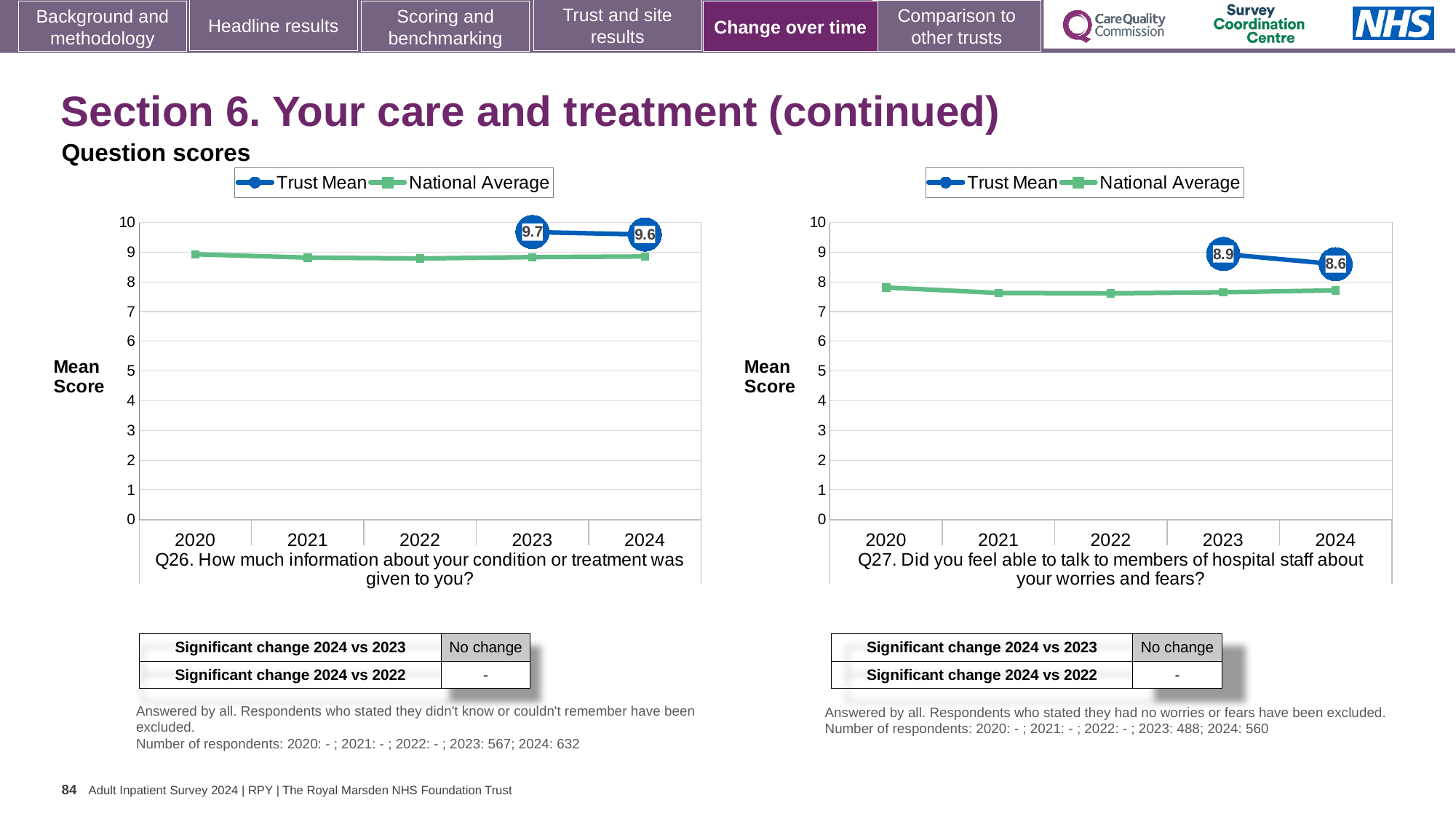
How many years are shown on the x axis of the Q27 chart (right)? 5 In the Q27 chart (right), does the Trust Mean rise or fall from 2023 to 2024? Fall In the Q27 chart (right), what is the Trust Mean value for 2023? 8.9 In the Q27 chart (right), what is the Trust Mean value for 2024? 8.6 In the Q26 chart (left), is the National Average value for 2024 greater or less than 9? less In the Q26 chart (left), is the Trust Mean for 2023 or 2024 higher? 2023 How many series does the legend of the Q26 chart (left) list? 2 In the Q27 chart (right), is the National Average value for 2020 greater or less than 8? less What kind of chart is used for Q26 (left)? Line chart In the Q26 chart (left), what is the Trust Mean value for 2024? 9.6 In the Q27 chart (right), by how much did the Trust Mean fall from 2023 to 2024? 0.3 In the Q26 chart (left), what is the Trust Mean value for 2023? 9.7